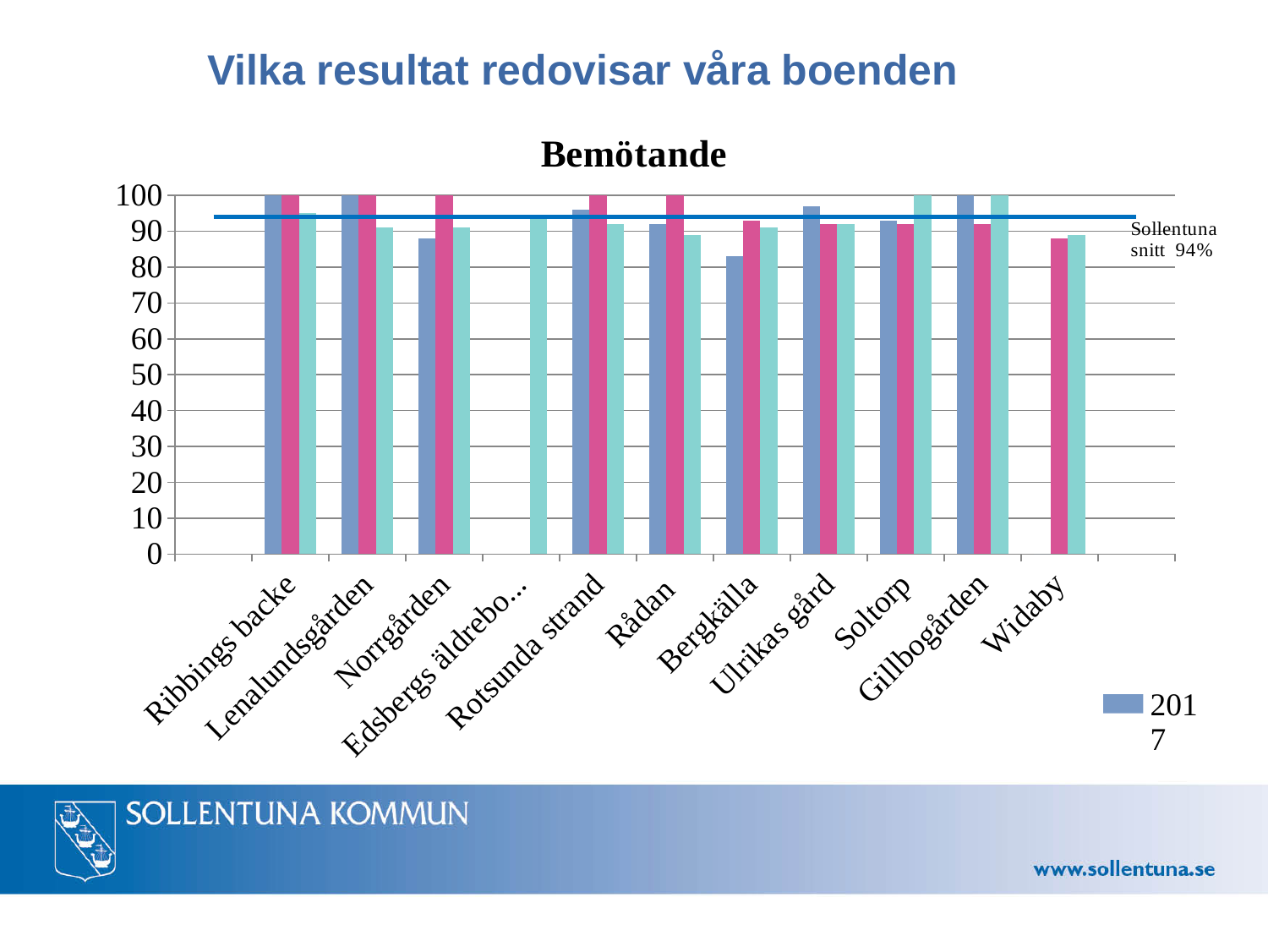
Is the value of the teal bar for Soltorp greater or less than 90? greater Is the value of the pink bar for Widaby greater or less than 90? less Is the value of the blue bar for Norrgården greater or less than 90? less Which is larger, the blue bar for Bergkälla or the blue bar for Rotsunda strand? Rotsunda strand What is the highest value shown on the y axis of the chart? 100 What is the title of the chart? Bemötande What value is given for the Sollentuna average (Sollentuna snitt) on the chart? 94% What kind of chart is shown on the slide? bar chart How many categories (boenden) are shown along the x axis of the chart? 11